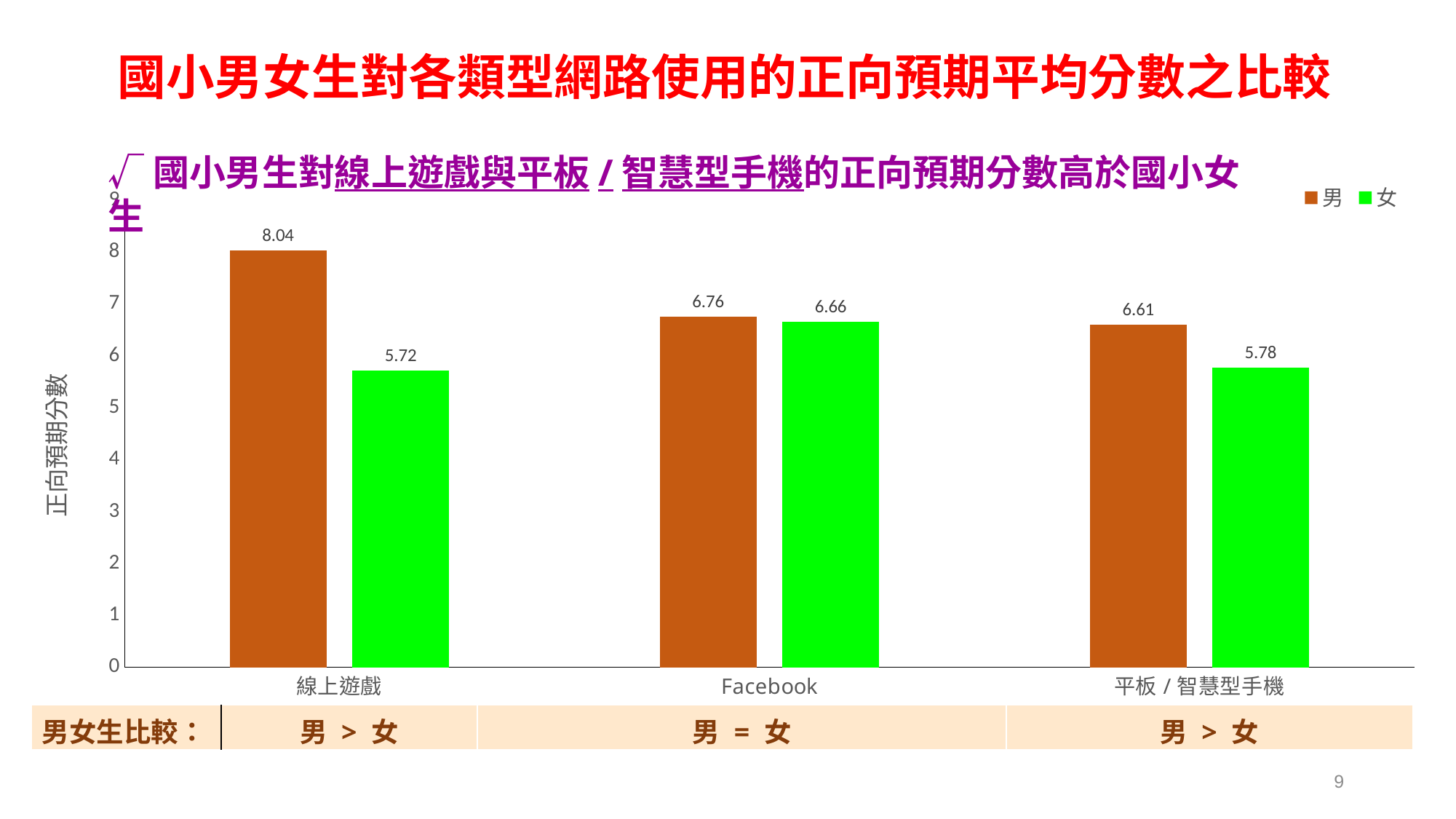
How many series does the legend list? 2 What is the value for 女 in the 線上遊戲 category? 5.72 How many categories are shown on the x axis? 3 What is the difference between the 男 and 女 values in the 線上遊戲 category? 2.32 Which category has the highest value for 男? 線上遊戲 What is the value for 男 in the Facebook category? 6.76 What kind of chart is shown on the slide? bar chart What is the value for 男 in the 線上遊戲 category? 8.04 In the 平板 / 智慧型手機 category, which is larger, the 男 value or the 女 value? 男 What is the value for 女 in the 平板 / 智慧型手機 category? 5.78 What is the label of the vertical axis? 正向預期分數 Which category has the lowest value for 女? 線上遊戲